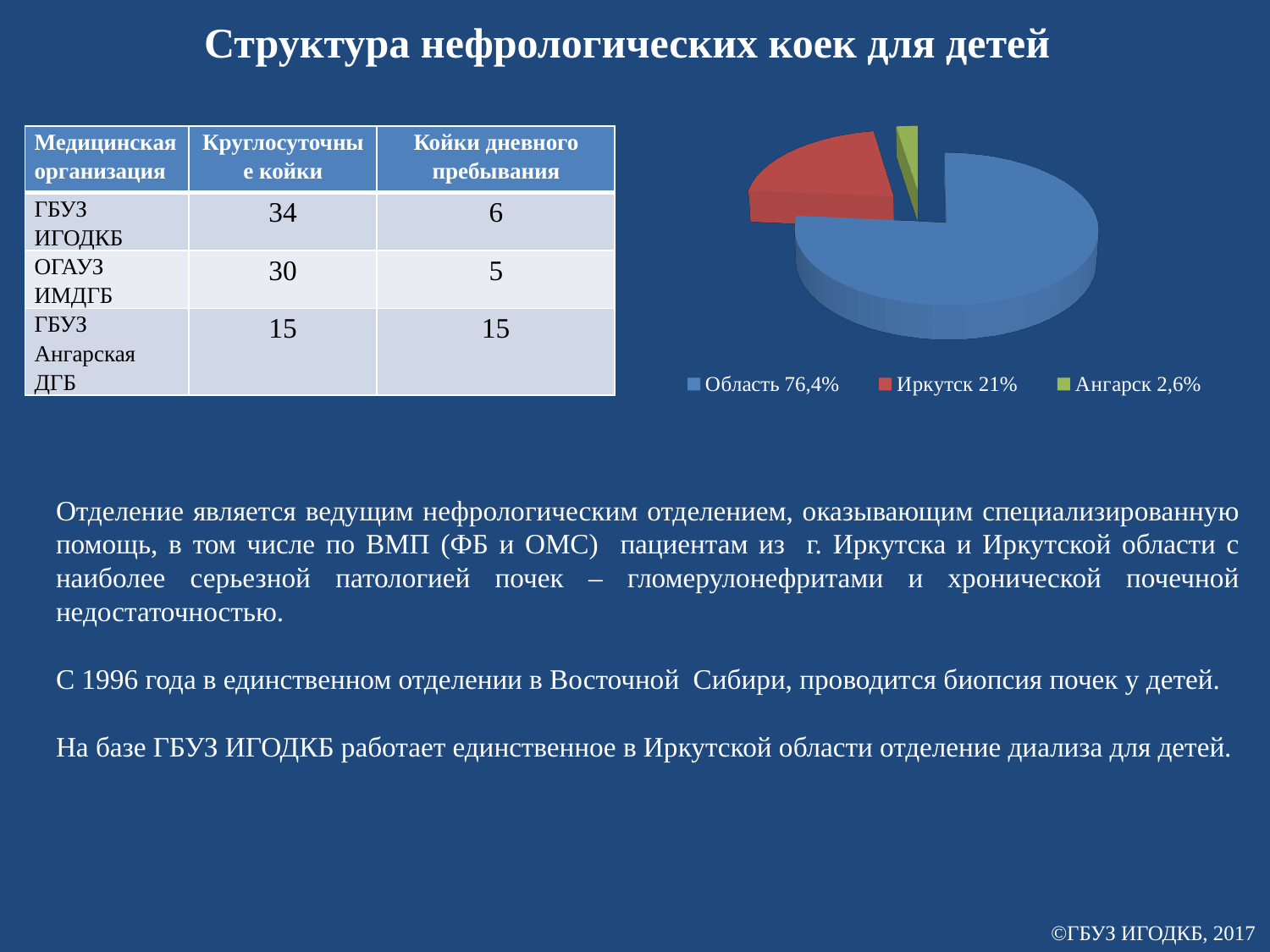
Which slice of the pie chart is the largest? Область What colour is the Иркутск slice in the pie chart? red How many slices does the pie chart have? 3 Which slice of the pie chart is the smallest? Ангарск What share of the pie does Область have? 76,4% How many entries does the pie chart legend list? 3 What kind of chart is shown on the slide? pie chart Which is larger in the pie chart, Иркутск or Ангарск? Иркутск What share of the pie does Ангарск have? 2,6% What is the difference between the shares of Иркутск and Ангарск in the pie chart? 18,4% What is the difference between the shares of Область and Иркутск in the pie chart? 55,4% What share of the pie does Иркутск have? 21%